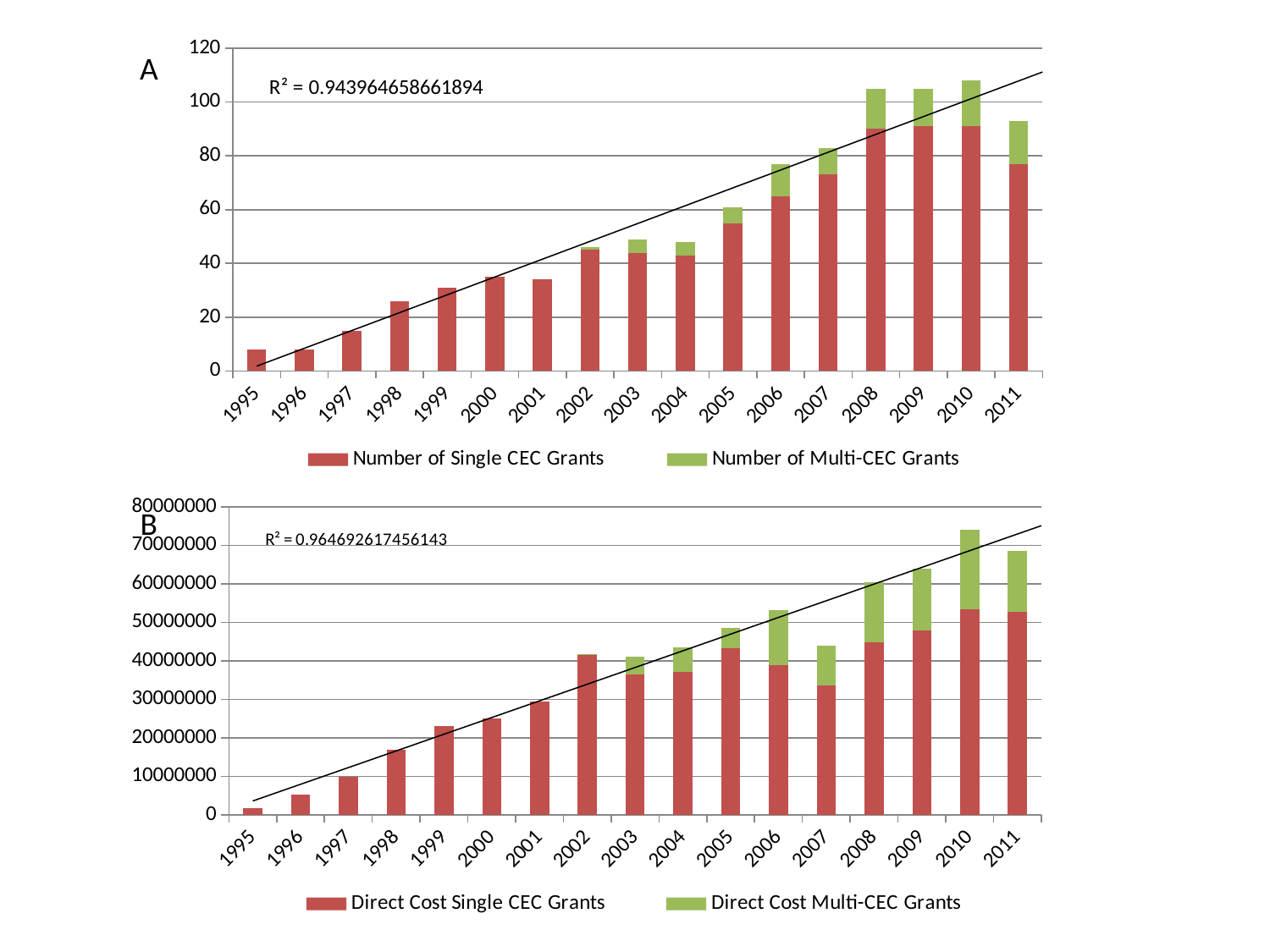
What R² value is printed on chart A (the top chart)? R² = 0.943964658661894 In chart A (the top chart), which year has the larger total number of grants, 2002 or 2005? 2005 In chart B (the bottom chart), is the total direct cost in 2007 greater or less than 50000000? less In chart B (the bottom chart), which year has the lowest total direct cost? 1995 How many years are shown on the x axis of chart B (the bottom chart)? 17 In chart B (the bottom chart), which year has the highest total direct cost? 2010 In chart B (the bottom chart), do the total direct costs generally rise or fall from 1995 to 2011? rise What type of chart is chart A (the top chart)? Stacked bar chart In chart A (the top chart), is the total number of grants in 2001 greater or less than 40? less How many series does the legend of chart A (the top chart) list? 2 What are the two legend entries of chart B (the bottom chart)? Direct Cost Single CEC Grants; Direct Cost Multi-CEC Grants In chart A (the top chart), is the number of Single CEC Grants in 2011 greater or less than 60? greater